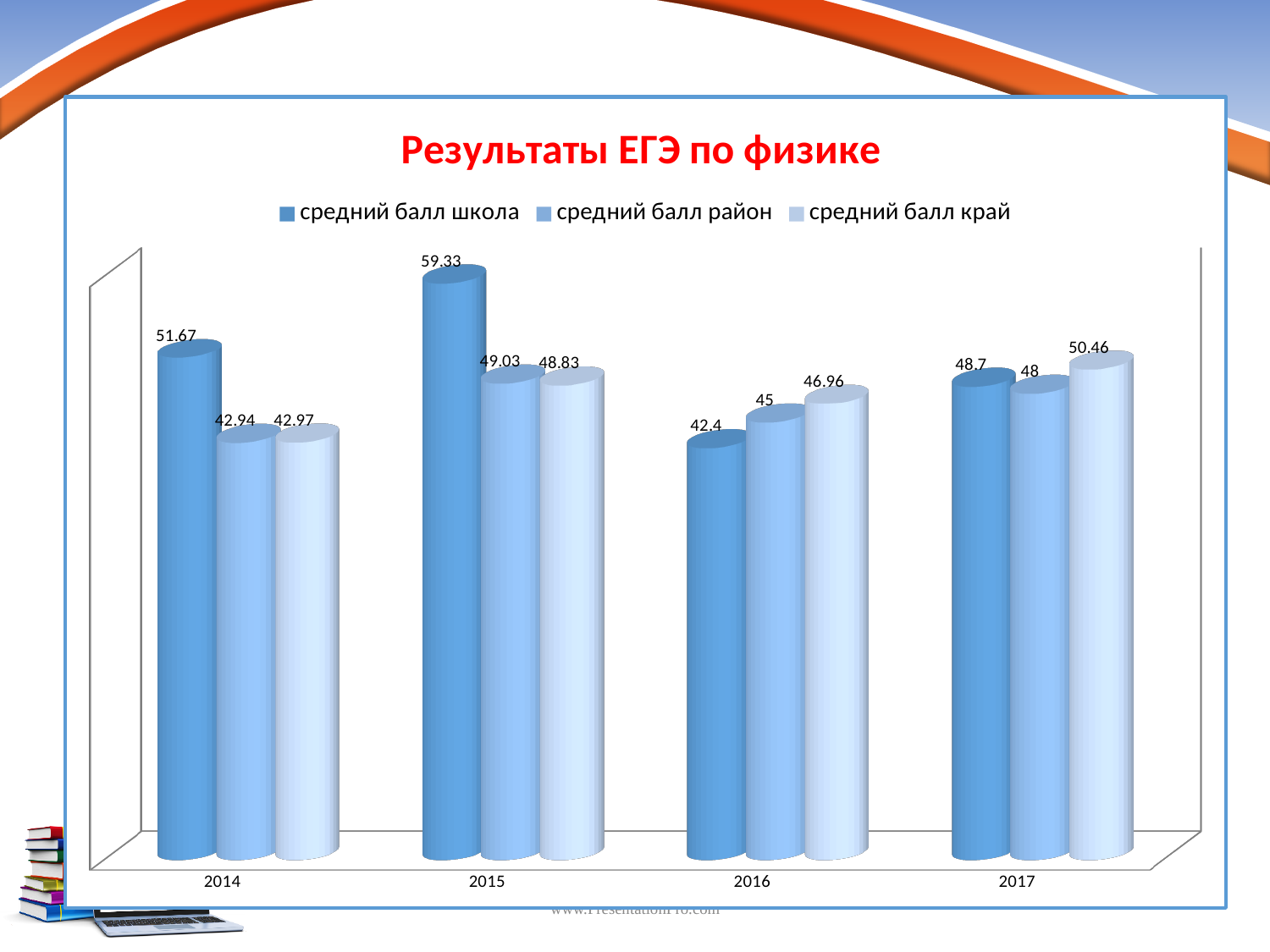
What is the value for средний балл школа in 2016? 42.4 How many series does the legend list? 3 What is the difference between средний балл школа and средний балл район in 2014? 8.73 What is the value for средний балл край in 2017? 50.46 What is the value for средний балл школа in 2015? 59.33 In which year is средний балл край the lowest? 2014 How many years are shown on the x axis? 4 What kind of chart is shown on the slide? bar chart What is the title of the chart? Результаты ЕГЭ по физике Which is larger in 2016: средний балл школа or средний балл край? средний балл край In which year is средний балл школа the highest? 2015 What is the value for средний балл район in 2014? 42.94